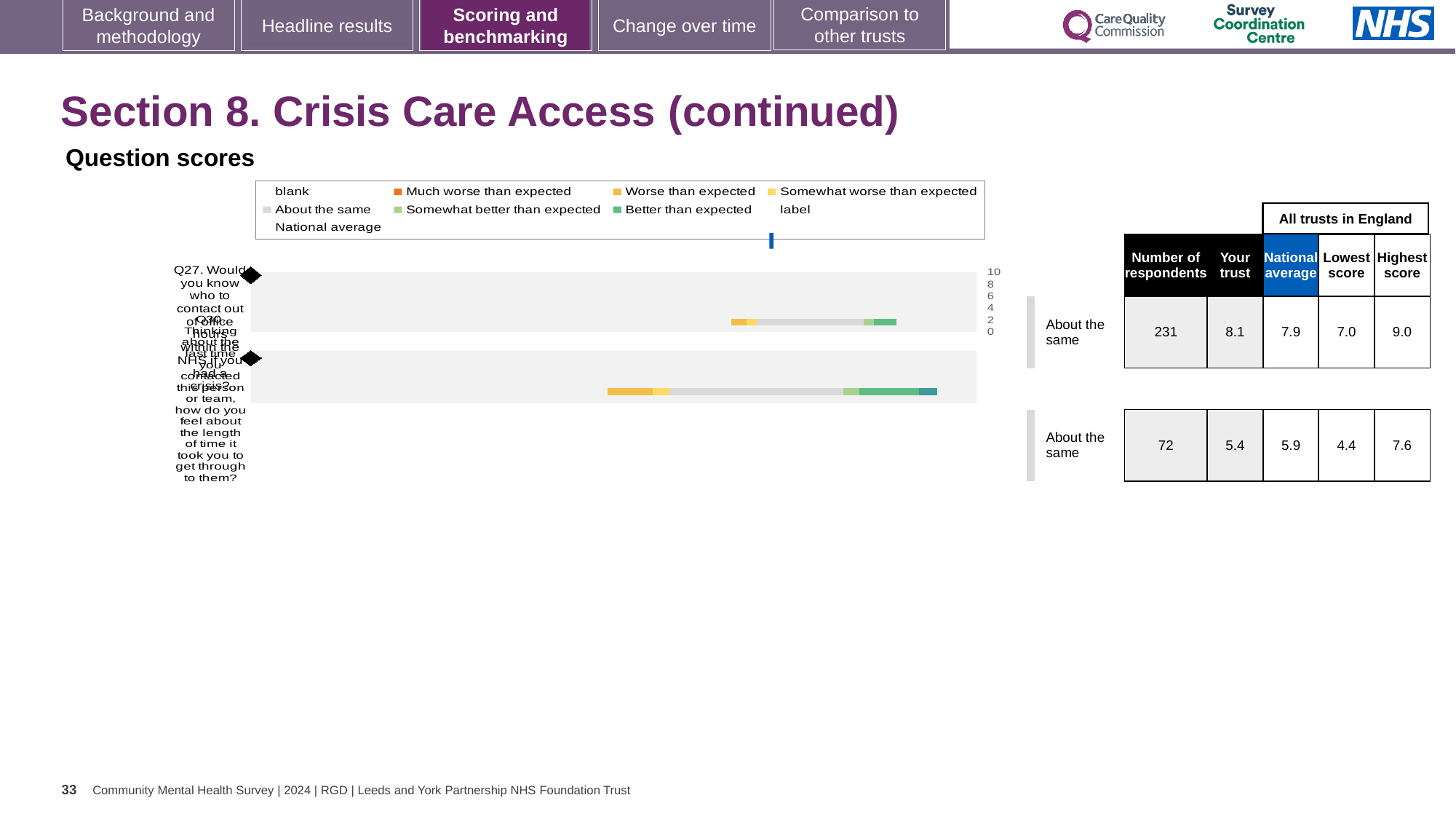
How many questions are plotted in the question scores chart? 2 What is the 'Your trust' score for Q27 (would you know who to contact out of office hours within the NHS if you had a crisis)? 8.1 How many respondents answered the second question (about the length of time it took to get through)? 72 What is the lowest score among all trusts in England for the second question (about the length of time it took to get through to the person or team)? 4.4 What is the difference between the highest score and the lowest score for Q27? 2.0 By how much is the 'Your trust' score below the national average for the second question (about the length of time it took to get through)? 0.5 What kind of chart is used to show the question scores on this slide? bar chart How many respondents answered Q27? 231 What benchmark category is shown next to the bar for Q27? About the same What is the national average score for Q27? 7.9 What is the highest score among all trusts in England for Q27? 9.0 For Q27, which is higher: the 'Your trust' score or the national average? Your trust